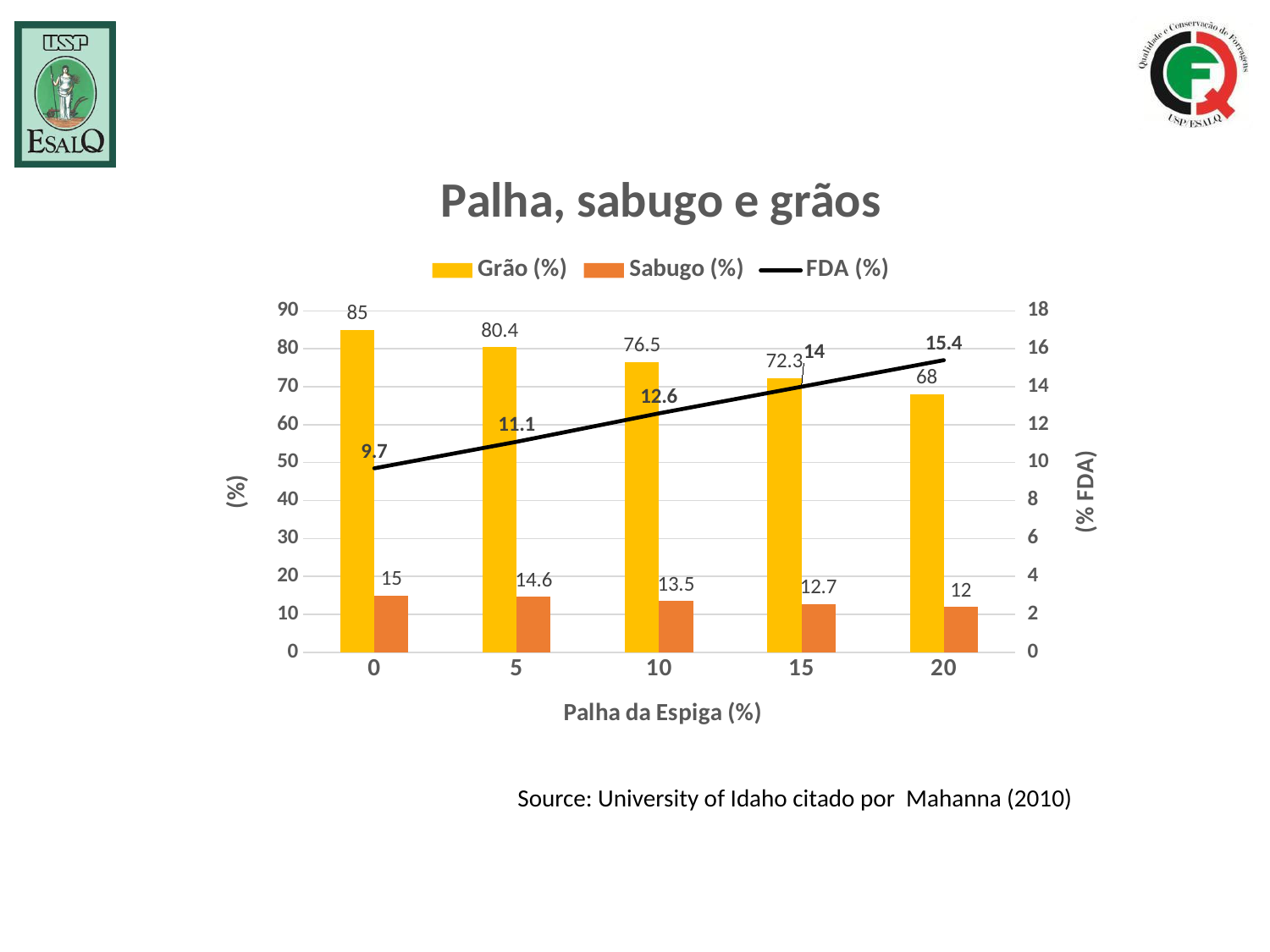
What is the FDA (%) value when Palha da Espiga is 20%? 15.4 What is the Grão (%) value when Palha da Espiga is 0%? 85 What kind of chart is this? Combined bar and line chart What is the title of the chart? Palha, sabugo e grãos How many Palha da Espiga (%) levels are shown on the x axis? 5 Which is larger: Sabugo (%) at 5% Palha da Espiga or Sabugo (%) at 15% Palha da Espiga? Sabugo (%) at 5% How many series does the legend list? 3 What is the Sabugo (%) value when Palha da Espiga is 10%? 13.5 What is the difference between the Grão (%) values at 0% and 20% Palha da Espiga? 17 At which Palha da Espiga (%) level is FDA (%) highest? 20 At which Palha da Espiga (%) level is Grão (%) lowest? 20 Does the FDA (%) line rise or fall as Palha da Espiga (%) increases? Rises